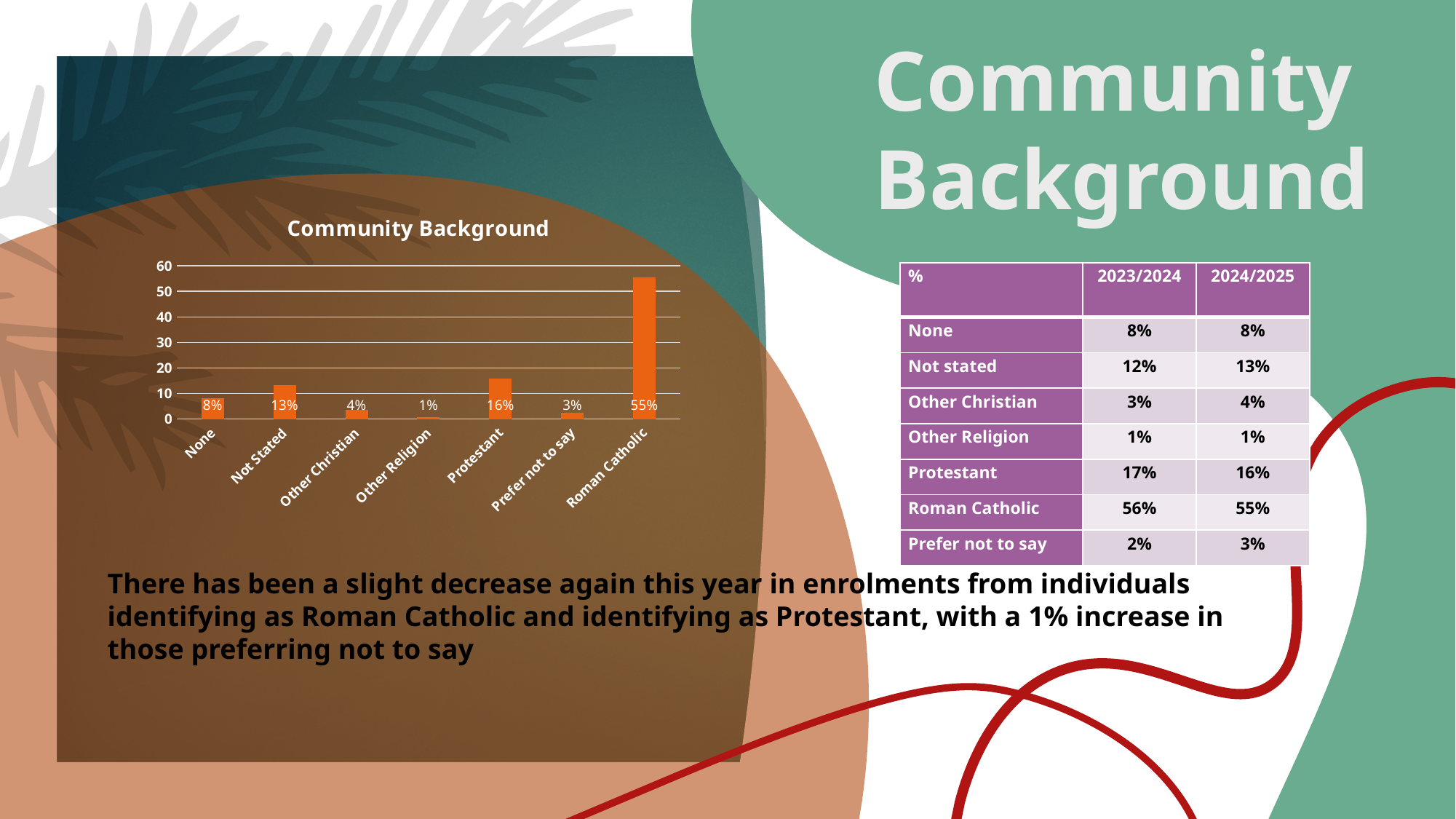
Which is larger in the Community Background chart, the value for None or the value for Other Christian? None What is the value for Other Religion in the Community Background chart? 1% Which category has the highest value in the Community Background chart? Roman Catholic What is the value for Roman Catholic in the Community Background chart? 55% How many categories are shown in the Community Background chart? 7 What is the difference between the values for Roman Catholic and Protestant in the Community Background chart? 39% What is the value for Protestant in the Community Background chart? 16% What is the title of the chart on the slide? Community Background Which category has the lowest value in the Community Background chart? Other Religion Is the value for Roman Catholic in the Community Background chart greater or less than 50? greater What kind of chart is the Community Background chart? bar chart What is the value for Not Stated in the Community Background chart? 13%